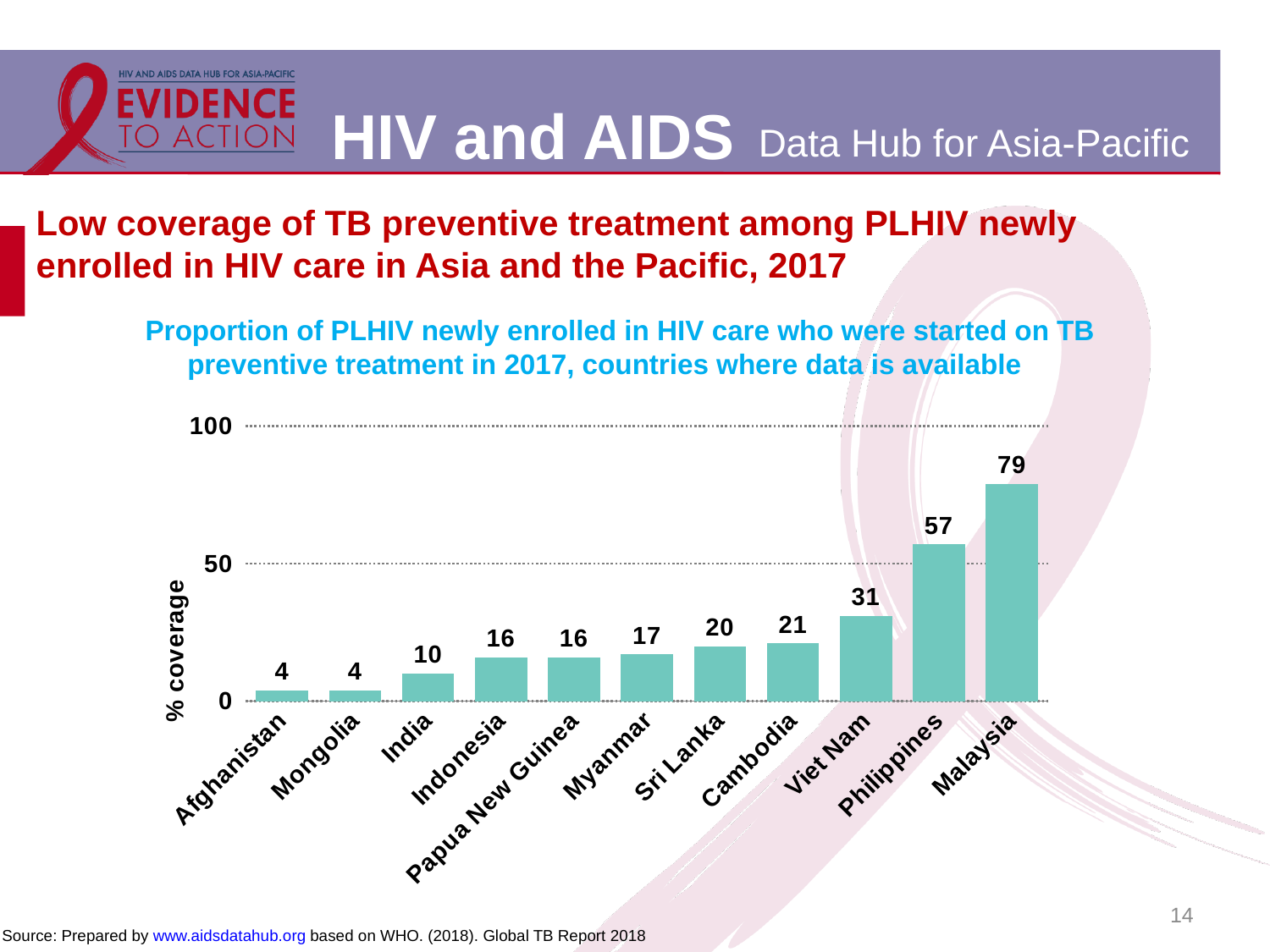
What is the % coverage value for Malaysia? 79 What kind of chart is shown on the slide? Bar chart What is the % coverage value for Viet Nam? 31 Is the value for the Philippines greater or less than 50? greater Do the values rise or fall from Afghanistan to Malaysia along the x axis? Rise What is the difference in % coverage between Malaysia and the Philippines? 22 Which has a higher % coverage, Sri Lanka or India? Sri Lanka Which country has the highest % coverage? Malaysia Which two countries share the lowest value of 4? Afghanistan and Mongolia What is the % coverage value for Cambodia? 21 What is the label of the y axis? % coverage How many countries are shown in the chart? 11